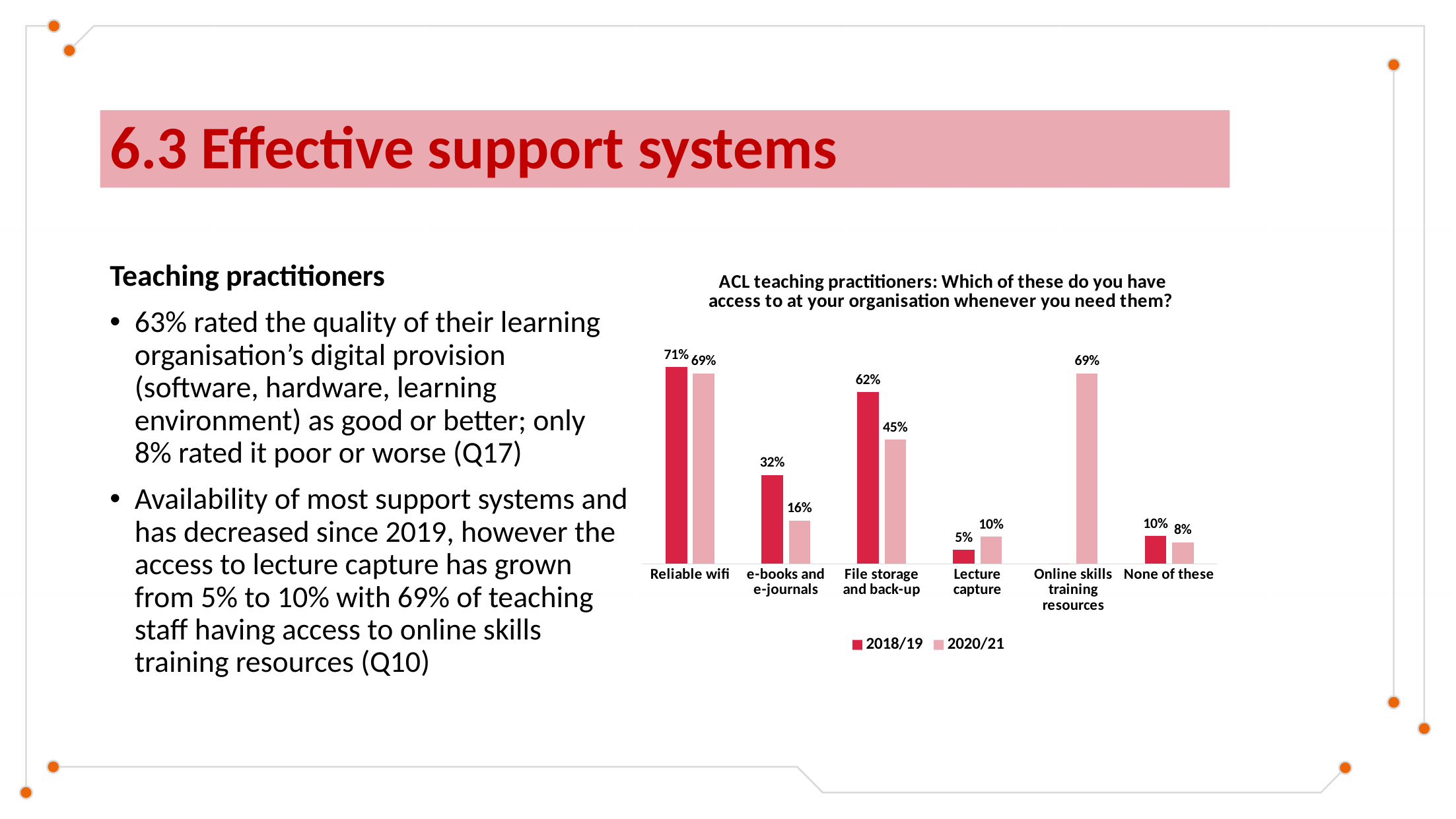
How many categories are shown on the x axis? 6 What is the 2018/19 value for Reliable wifi? 71% What is the 2020/21 value for File storage and back-up? 45% How many series does the legend list? 2 What are the two series named in the legend? 2018/19 and 2020/21 What is the 2020/21 value for Online skills training resources? 69% What is the difference between the 2018/19 and 2020/21 values for File storage and back-up? 17% What kind of chart is shown on the slide? Bar chart What is the difference between the 2018/19 and 2020/21 values for e-books and e-journals? 16% Which is larger for Lecture capture: the 2018/19 value or the 2020/21 value? 2020/21 Which category has the highest 2018/19 value? Reliable wifi